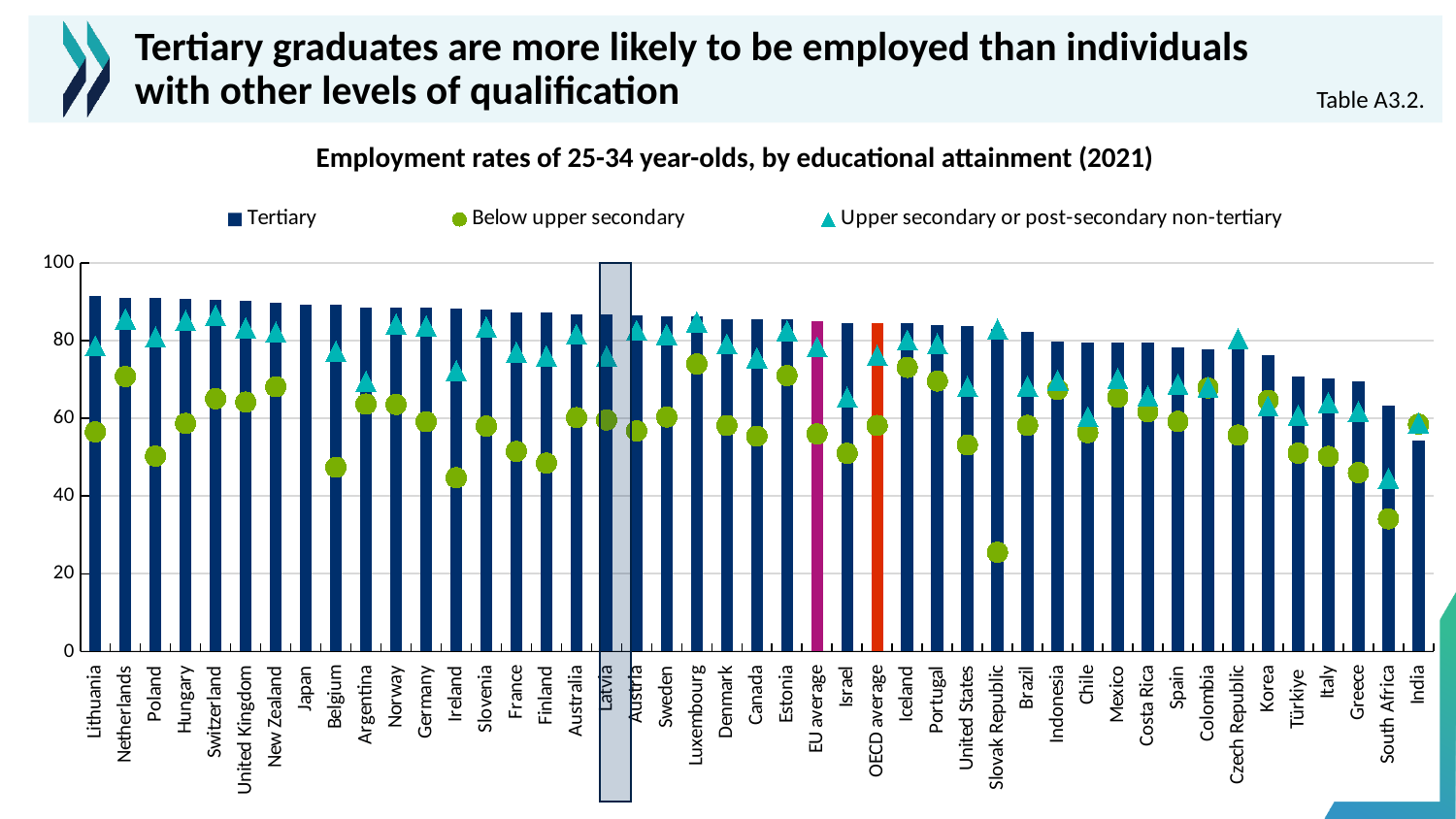
What kind of chart is shown on the slide? bar chart Which country has the highest Tertiary employment rate? Lithuania Which is larger, the Tertiary value for Lithuania or the Tertiary value for India? Lithuania Which country has the lowest Below upper secondary employment rate? Slovak Republic Which country has the lowest Tertiary employment rate? India Do the Tertiary values rise or fall moving from left to right along the x axis? fall Is the Below upper secondary value for Ireland greater or less than 60? less Is the Below upper secondary value for the Slovak Republic greater or less than 40? less How many countries or averages are shown along the x axis? 45 Is the Tertiary value for India greater or less than 60? less How many series does the legend list? 3